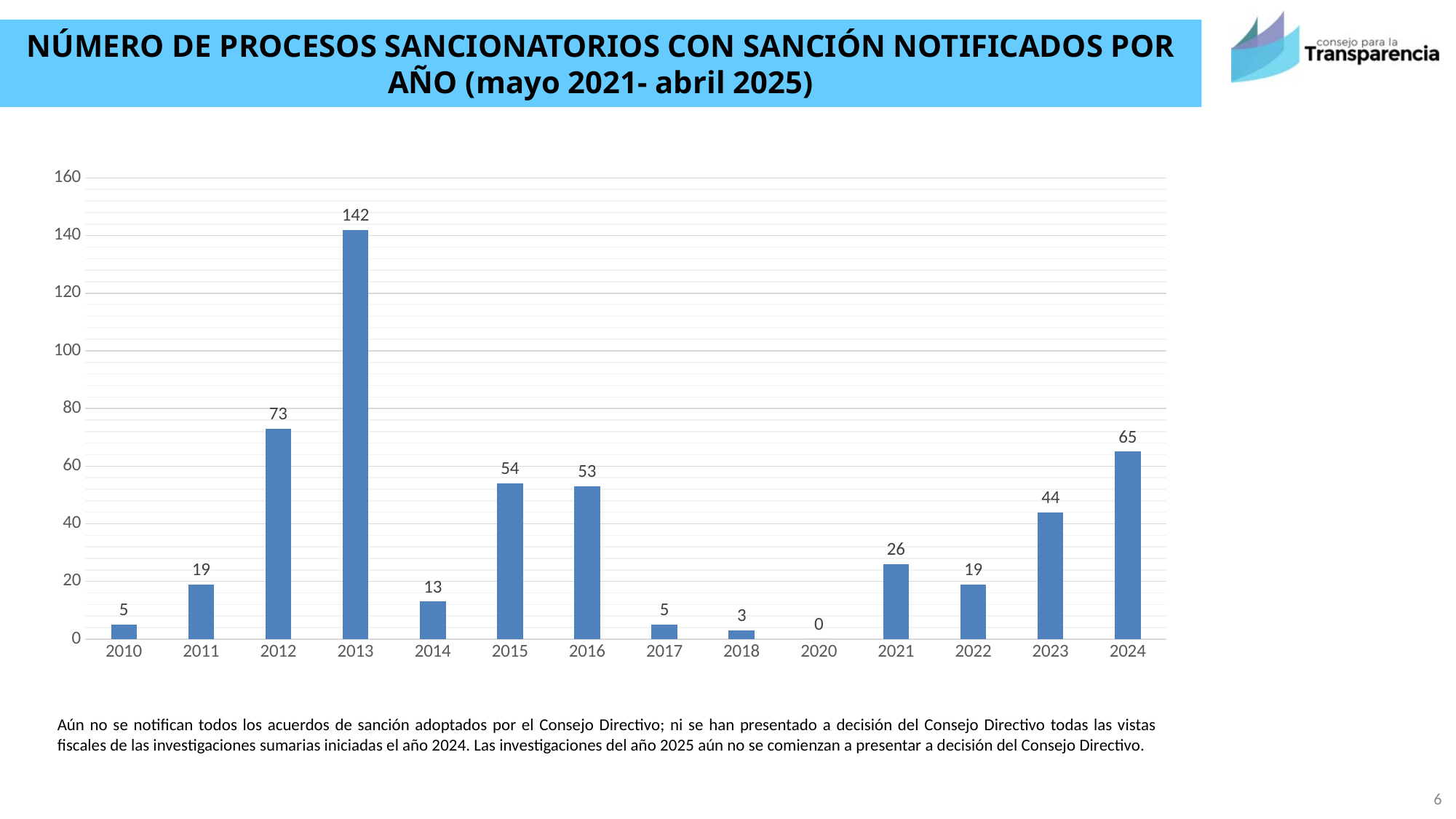
What is the difference between the values for 2013 and 2012? 69 What is the value for 2013? 142 What kind of chart is shown on the slide? bar chart Which is larger, the value for 2015 or the value for 2024? 2024 How many years are shown on the x axis? 14 What is the value for 2020? 0 What is the value for 2024? 65 Which year has the highest value? 2013 What is the difference between the values for 2023 and 2022? 25 Which year has the lowest value? 2020 Is the value for 2012 greater or less than 60? greater Do the values rise or fall from 2021 to 2024? rise